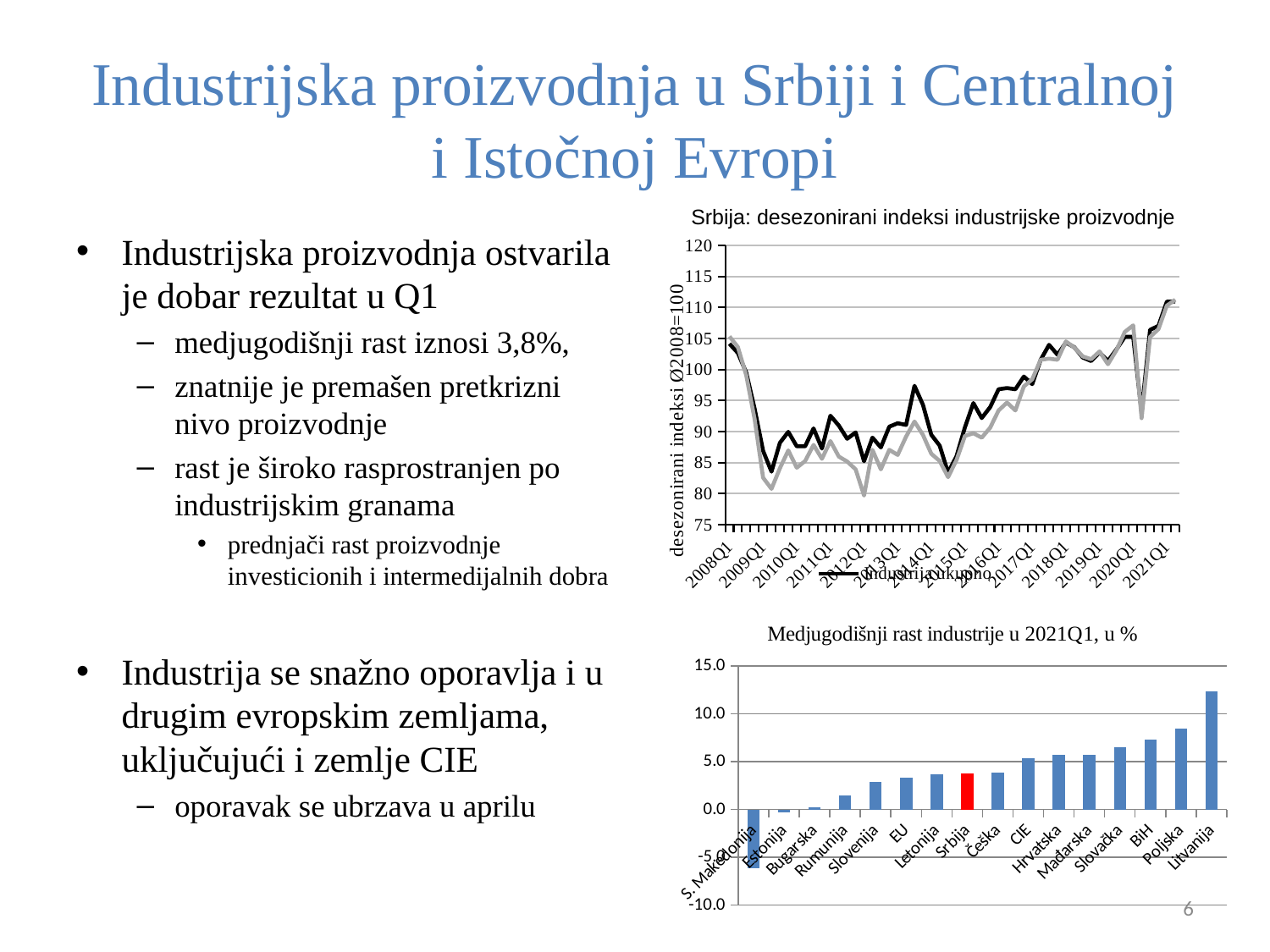
What kind of chart is the top chart titled 'Srbija: desezonirani indeksi industrijske proizvodnje'? line chart In the top line chart, is the value of the black line at 2009Q1 greater or less than 90? less In the bottom bar chart, is the value for Srbija greater or less than 5.0? less In the bottom bar chart, which country has the lowest industrial growth in 2021Q1? S. Makedonija In the bottom bar chart, how many countries or regions are shown on the x axis? 16 What kind of chart is the bottom chart titled 'Medjugodišnji rast industrije u 2021Q1, u %'? bar chart In the bottom bar chart, which country's bar is coloured red? Srbija In the bottom bar chart, which country has the highest industrial growth in 2021Q1? Litvanija In the bottom bar chart, is the value for S. Makedonija greater or less than -5.0? less In the bottom bar chart, which has the larger value, Poljska or BiH? Poljska In the bottom bar chart, do the values generally rise or fall from left to right along the x axis? rise